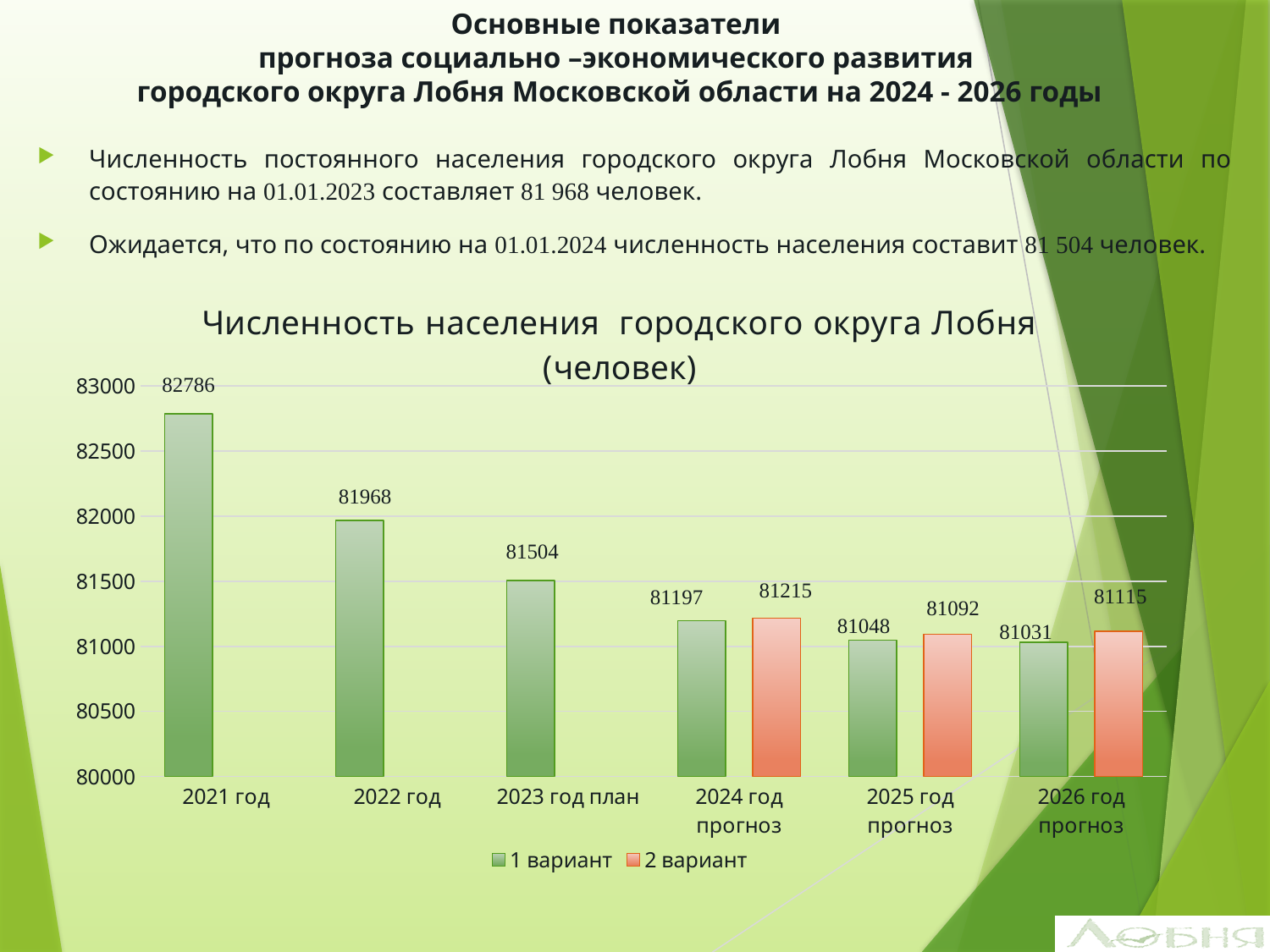
How many categories are shown on the x axis? 6 Do the 1 вариант values rise or fall from 2021 год to 2026 год прогноз? fall Which category has the highest value for 1 вариант? 2021 год Which category has the lowest value for 1 вариант? 2026 год прогноз In 2026 год прогноз, which is larger: 1 вариант or 2 вариант? 2 вариант What is the value for 1 вариант in 2023 год план? 81504 What is the value for 1 вариант in 2021 год? 82786 How many series does the legend list? 2 What is the value for 2 вариант in 2025 год прогноз? 81092 Is the value for 1 вариант in 2022 год greater or less than 82000? less What is the difference between the 1 вариант values for 2021 год and 2022 год? 818 What type of chart is shown on the slide? bar chart